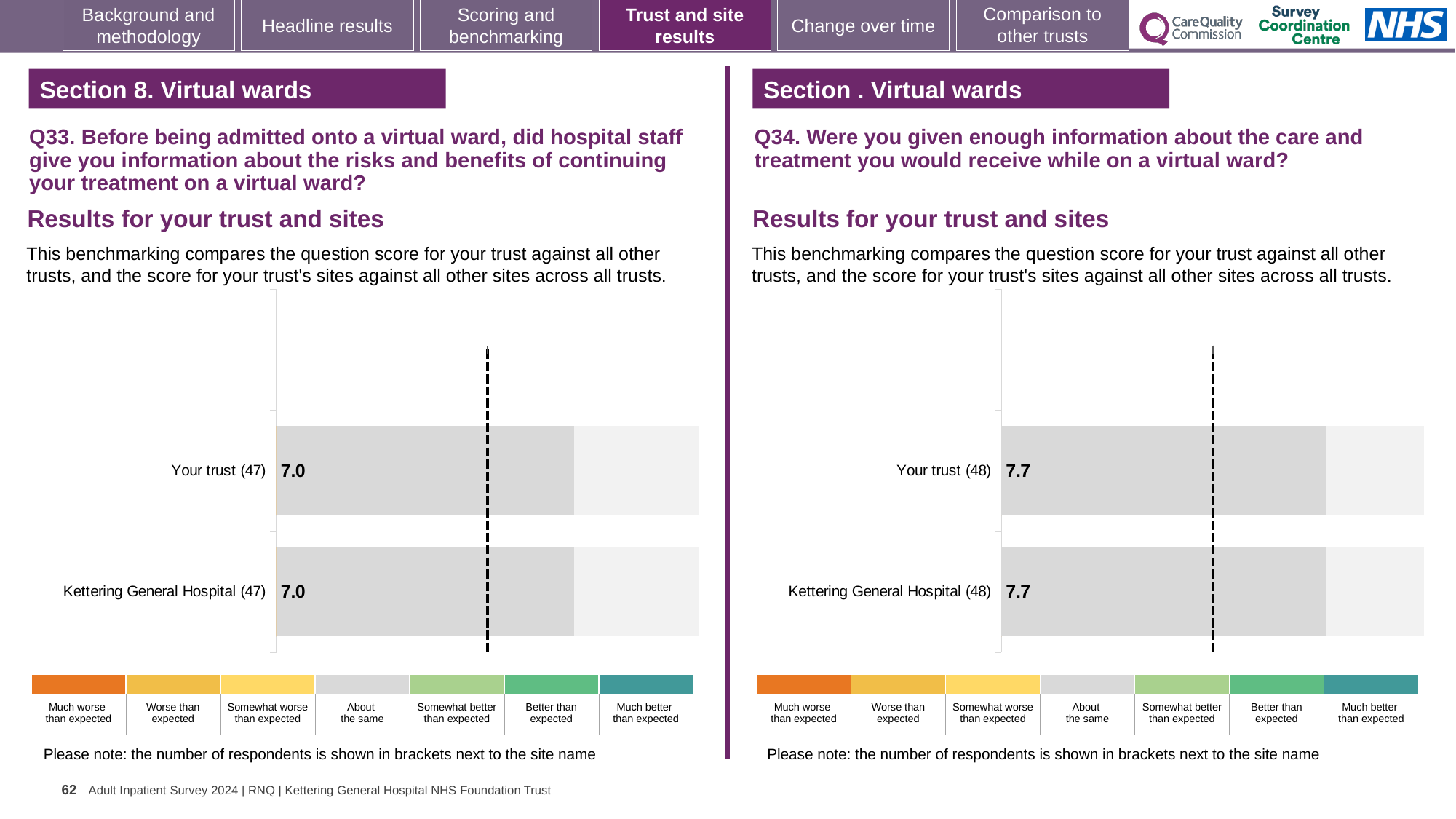
How many bars are plotted in the Q33 chart on the left? 2 In the Q34 chart on the right, what is the score for Your trust? 7.7 In the Q33 chart on the left, how many respondents are shown in brackets next to Kettering General Hospital? 47 In the Q34 chart on the right, how many respondents are shown in brackets next to Your trust? 48 In the Q33 chart on the left, what is the score for Your trust? 7.0 In the Q34 chart on the right, what is the difference between the score for Your trust and the score for Kettering General Hospital? 0.0 In the Q34 chart on the right, what is the score for Kettering General Hospital? 7.7 How many bars are plotted in the Q34 chart on the right? 2 What kind of chart is the Q34 chart on the right? Bar chart In the Q33 chart on the left, what is the score for Kettering General Hospital? 7.0 Is the score for Your trust in the Q34 chart on the right larger or smaller than the score for Your trust in the Q33 chart on the left? Larger In the Q33 chart on the left, what is the difference between the score for Your trust and the score for Kettering General Hospital? 0.0